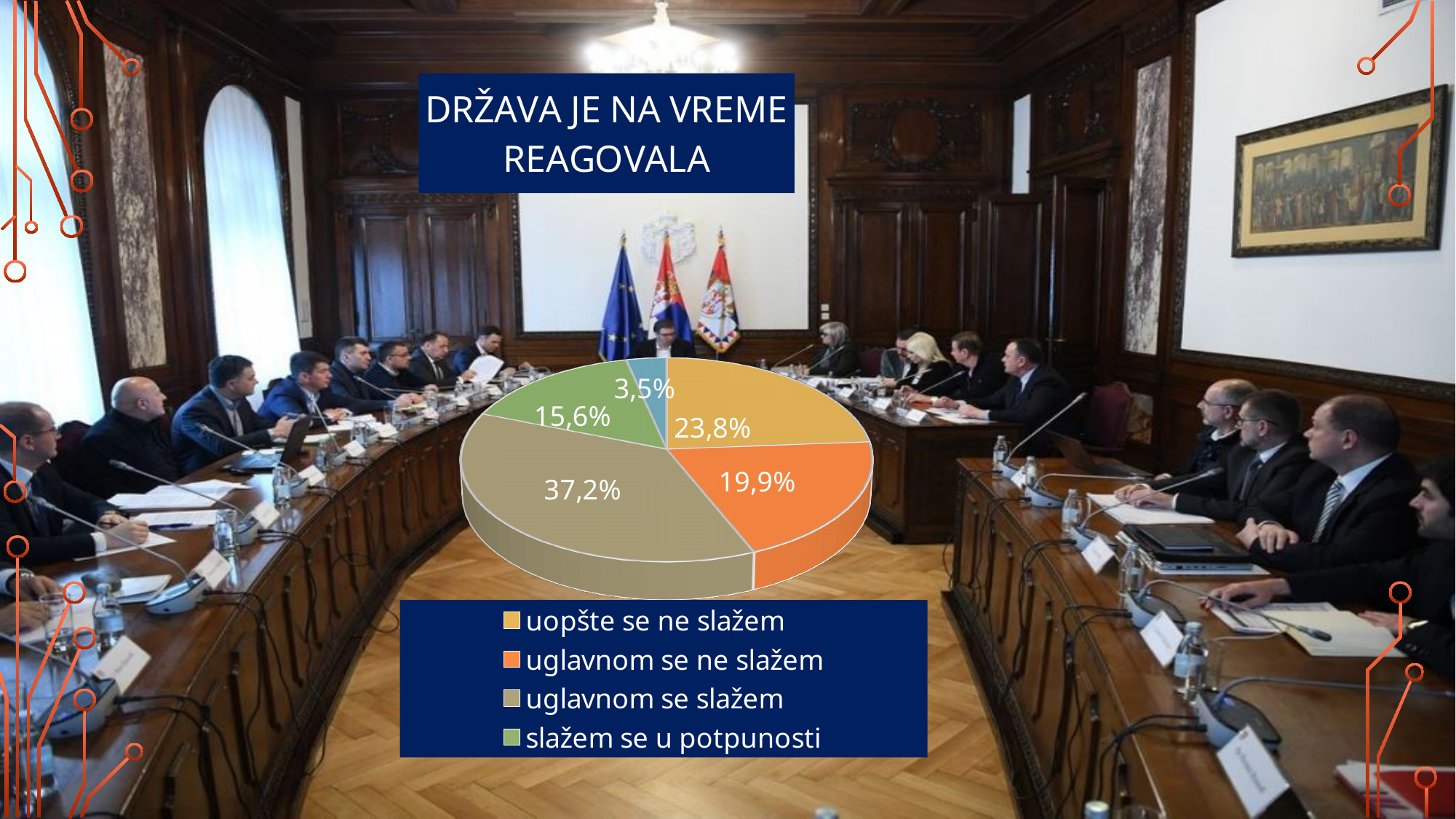
How many entries does the legend list? 4 Which legend category has the largest share of the pie chart? uglavnom se slažem What percentage of the pie chart corresponds to "slažem se u potpunosti"? 15,6% What percentage of the pie chart corresponds to "uglavnom se ne slažem"? 19,9% What is the title shown above the chart on the slide? DRŽAVA JE NA VREME REAGOVALA What percentage of the pie chart corresponds to "uglavnom se slažem"? 37,2% What is the difference in percentage points between "uglavnom se slažem" and "uopšte se ne slažem"? 13,4 How many slices does the pie chart have? 5 What percentage of the pie chart corresponds to "uopšte se ne slažem"? 23,8% What is the smallest percentage shown on the pie chart? 3,5% Which is larger: the share for "uopšte se ne slažem" or the share for "uglavnom se ne slažem"? uopšte se ne slažem What type of chart is shown on the slide? Pie chart